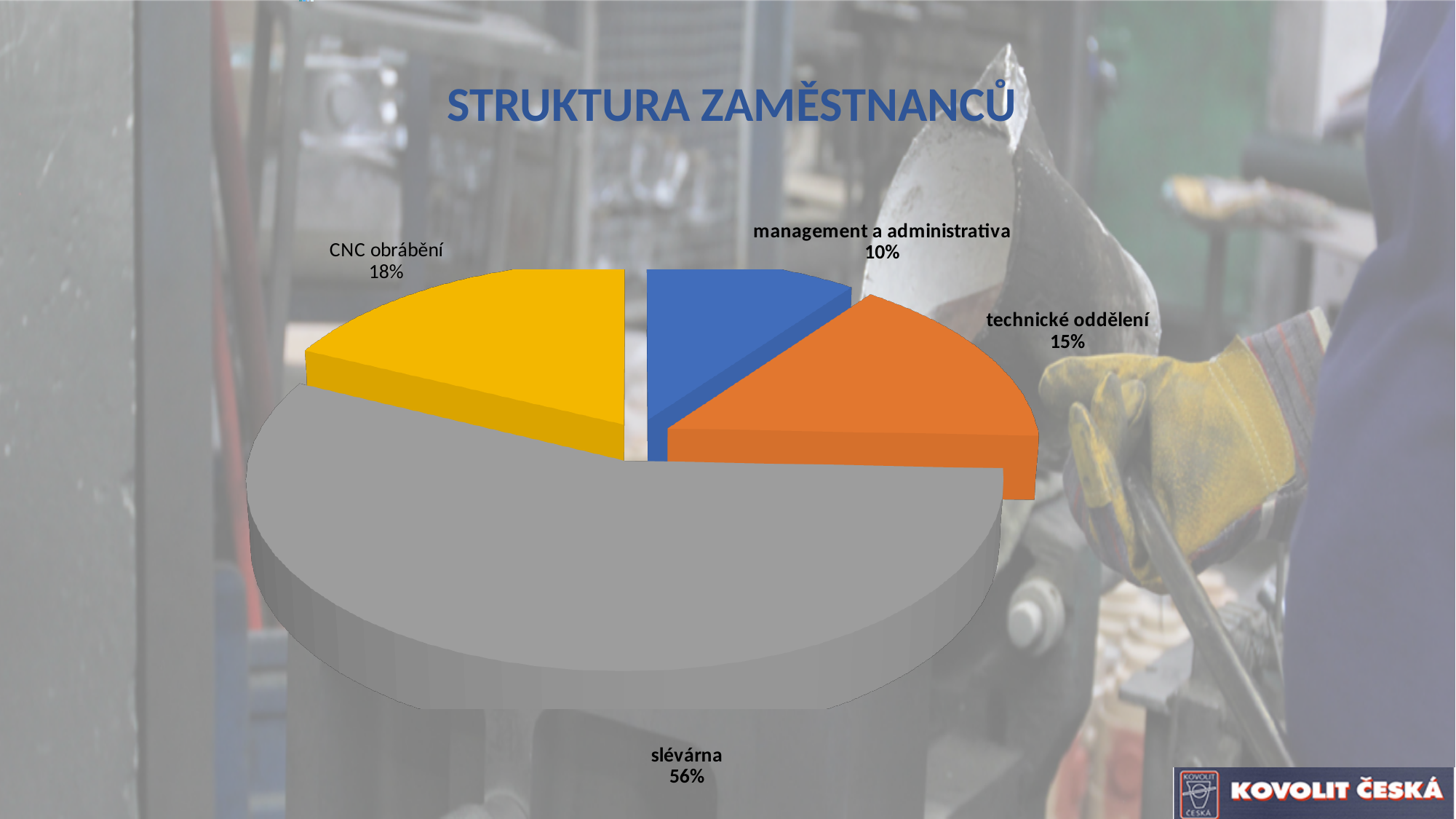
What colour is the slice for slévárna? grey What share of employees does slévárna represent? 56% What share of employees does technické oddělení represent? 15% What share of employees does management a administrativa represent? 10% How many categories does the pie chart show? 4 What kind of chart is shown on the slide? pie chart What is the title of the chart? STRUKTURA ZAMĚSTNANCŮ Which is larger, the share for CNC obrábění or the share for technické oddělení? CNC obrábění Which category has the smallest share of employees? management a administrativa What is the difference in percentage points between slévárna and CNC obrábění? 38 Which category has the largest share of employees? slévárna